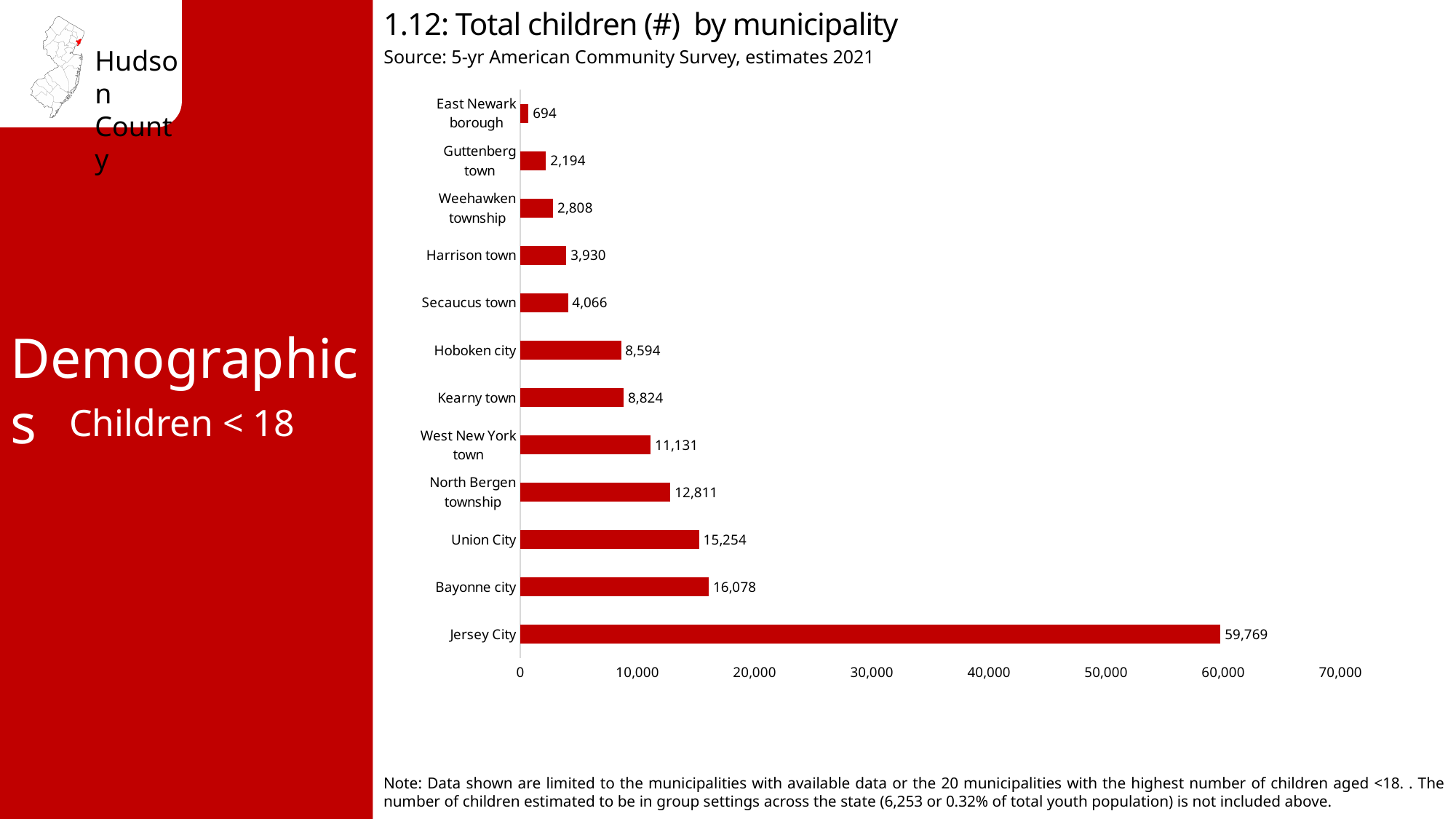
How many municipalities are shown in the chart? 12 Is the value for West New York town greater or less than 10,000? greater What is the difference in the number of children between Bayonne city and Union City? 824 What is the difference in the number of children between Jersey City and Bayonne city? 43,691 What is the total number of children in Hoboken city? 8,594 What is the source of the data shown in the chart? 5-yr American Community Survey, estimates 2021 What kind of chart is shown on the slide? bar chart Which has more children, Kearny town or Secaucus town? Kearny town What is the total number of children in Jersey City? 59,769 Which municipality has the highest number of children? Jersey City What is the total number of children in North Bergen township? 12,811 Which municipality has the lowest number of children? East Newark borough